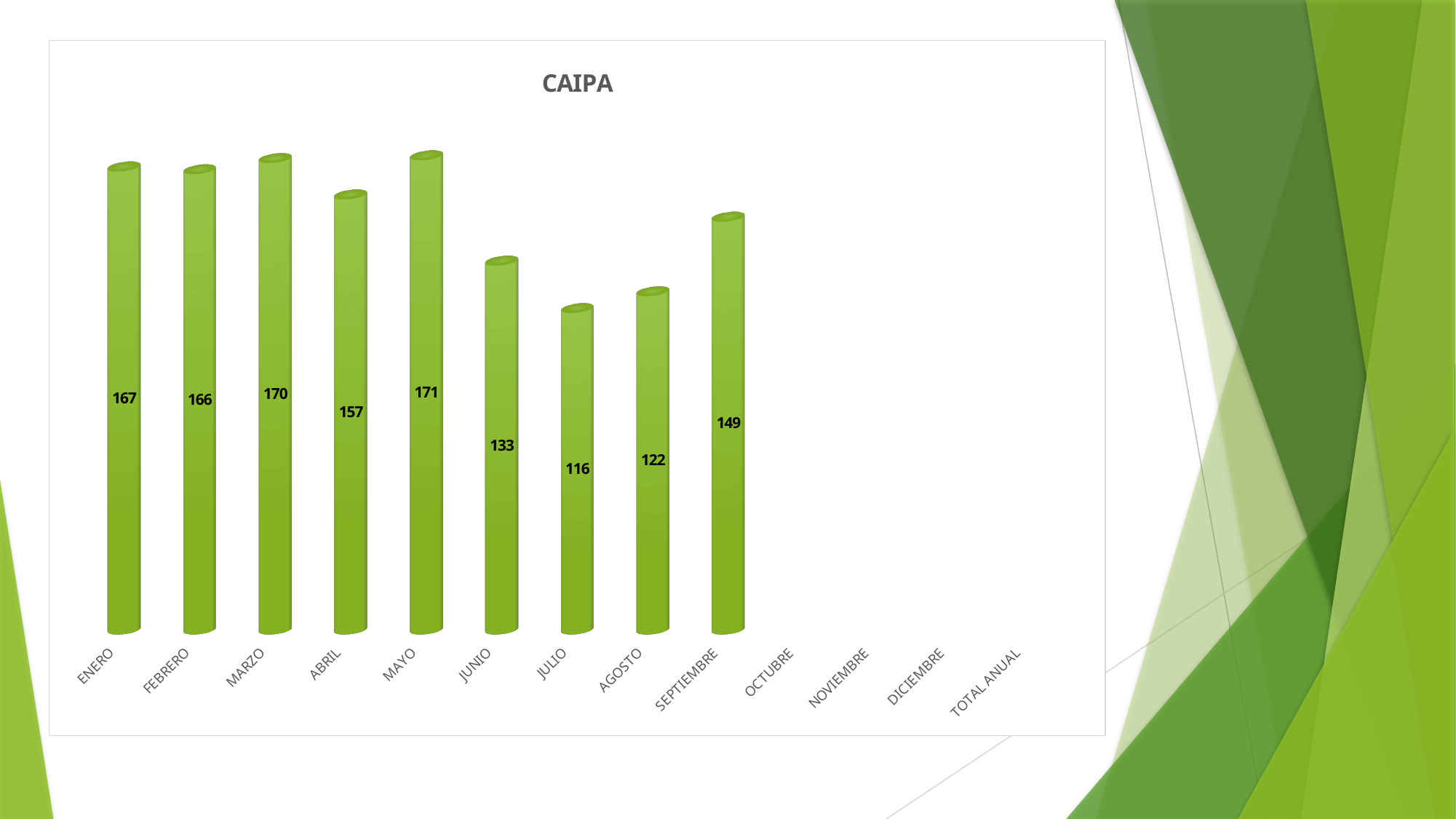
What is the difference between the values for ENERO and JUNIO? 34 How many months have a bar plotted on the chart? 9 What is the value for JULIO? 116 What is the difference between the values for MARZO and AGOSTO? 48 Which month has the highest value? MAYO What is the value for MAYO? 171 Which is larger, the value for FEBRERO or the value for SEPTIEMBRE? FEBRERO What is the value for SEPTIEMBRE? 149 What kind of chart is shown? Bar chart What is the title of the chart? CAIPA What is the value for ABRIL? 157 Which month has the lowest value? JULIO